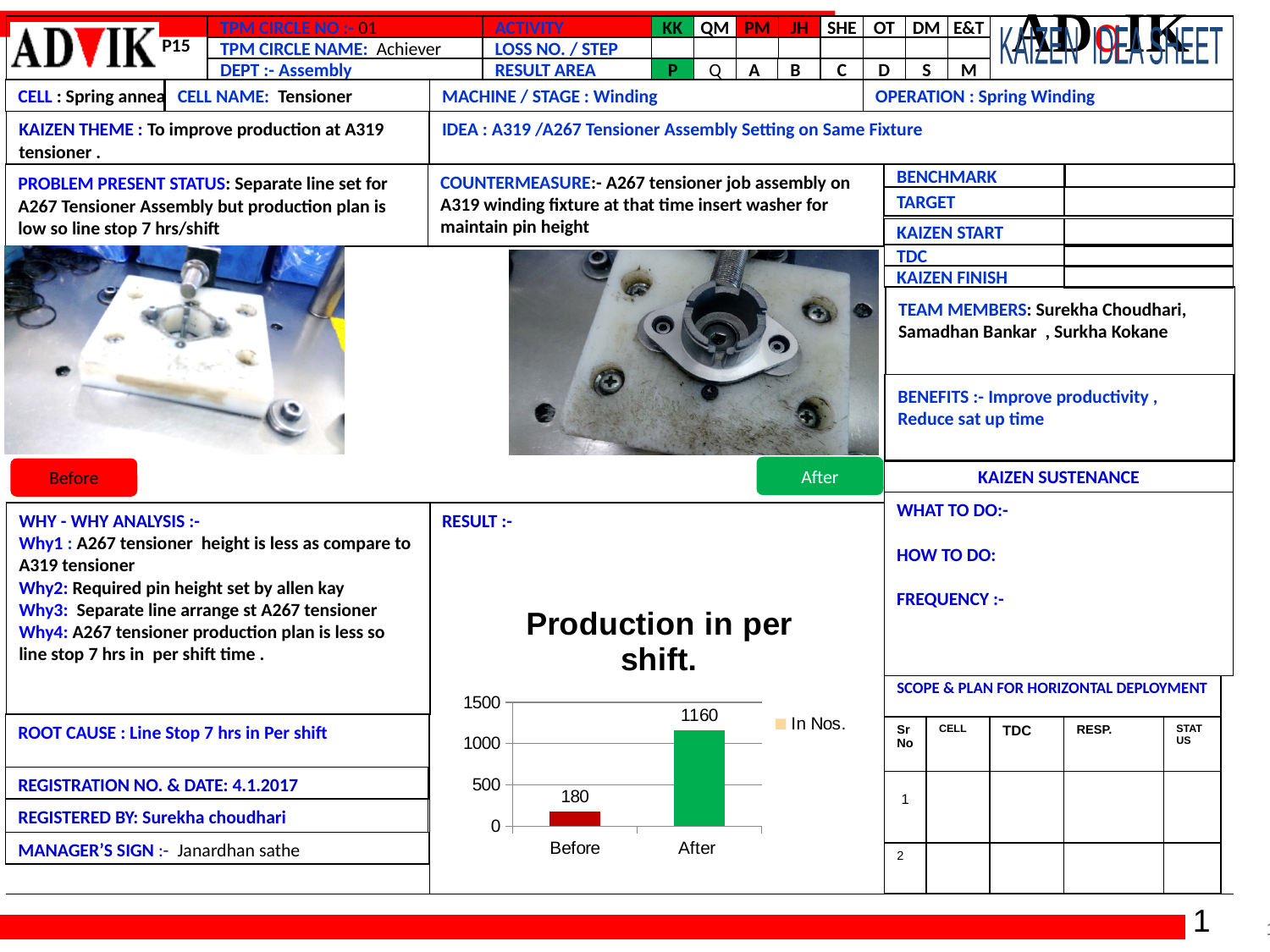
How many categories are shown on the x axis of the chart? 2 How many series does the chart legend list? 1 What is the title of the chart on the slide? Production in per shift. Which category has the higher value, Before or After? After Which category has the lowest value in the chart? Before What is the difference between the After and Before values? 980 Do the values rise or fall from Before to After? rise What is the legend entry for the series in the chart? In Nos. What type of chart is shown under RESULT? bar chart Is the value for After greater or less than 1000? greater What is the value for Before in the Production in per shift chart? 180 What is the value for After in the Production in per shift chart? 1160